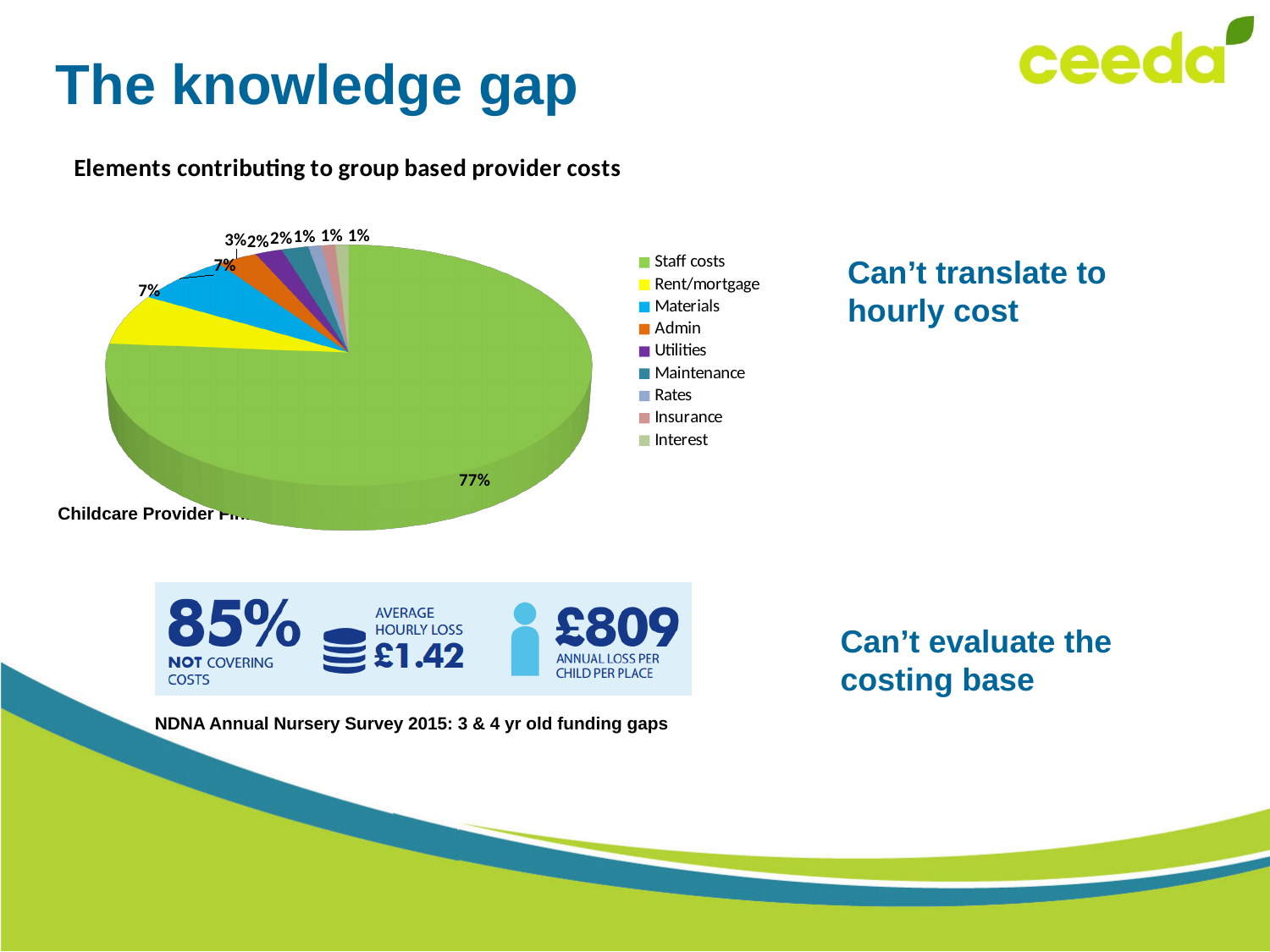
What is the title of the pie chart? Elements contributing to group based provider costs Which categories share the smallest slice of the pie, at 1% each? Rates, Insurance, Interest By how many percentage points does Staff costs exceed Materials? 70 percentage points Which legend entry is shown in yellow? Rent/mortgage How many categories does the pie chart's legend list? 9 What share of the pie does Staff costs take? 77% Which is larger, the share for Admin or the share for Utilities? Admin What kind of chart is shown on the slide? Pie chart Which category accounts for the largest share of provider costs? Staff costs What percentage of costs is attributed to Rent/mortgage? 7% What percentage of costs is attributed to Admin? 3% What percentage of group based provider costs is attributed to Staff costs? 77%